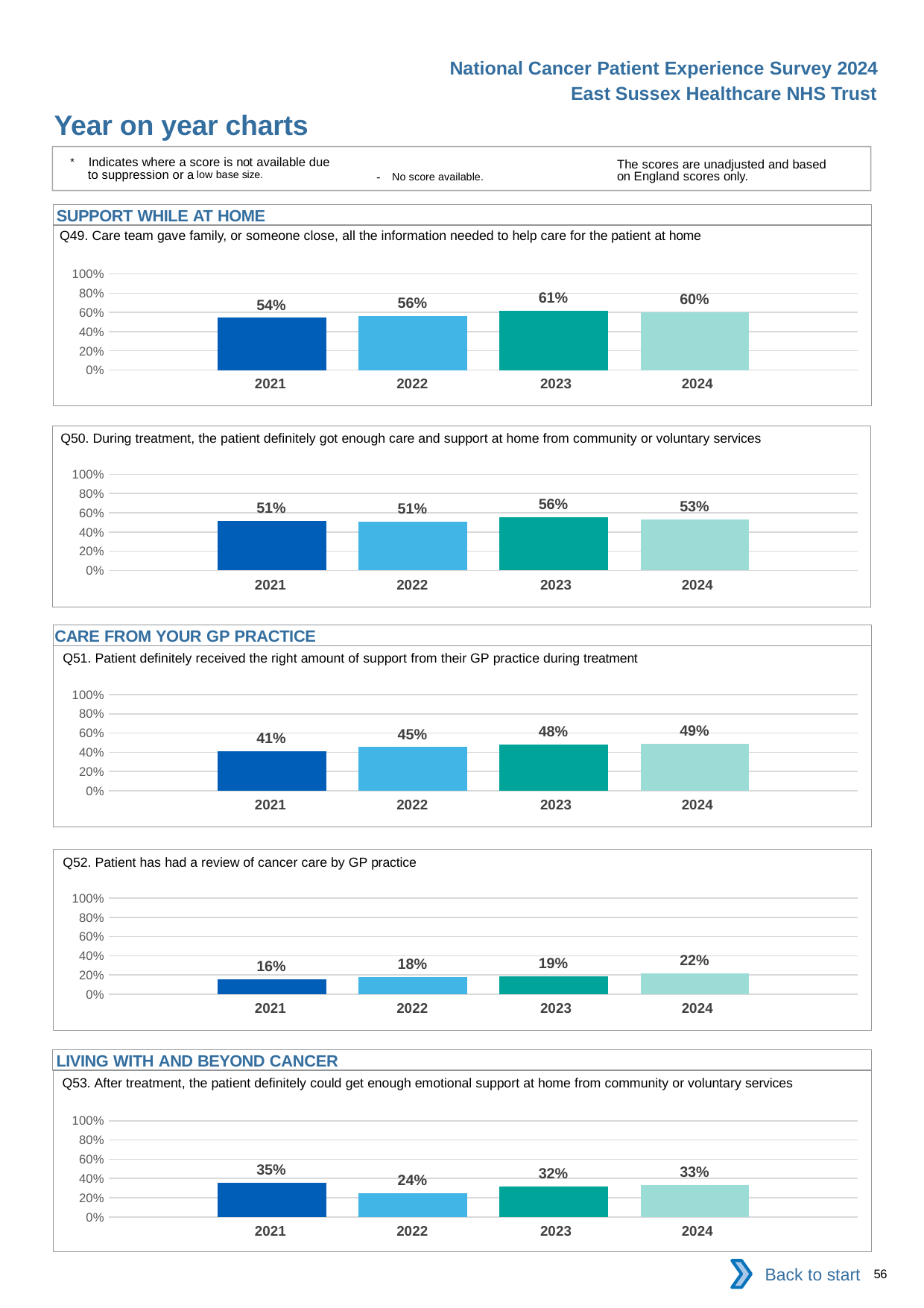
In the Q50 chart, what is the difference between the 2023 and 2024 values? 3% In the Q52 chart, is the value for 2021 greater or less than 20%? less How many years are plotted in the Q53 chart? 4 In the Q49 chart, which year has the lowest value? 2021 In the Q49 chart, what is the value for 2023? 61% In the Q52 chart, what is the value for 2024? 22% What kind of chart is the Q49 chart? bar chart In the Q53 chart, which year has the lowest value? 2022 In the Q50 chart, which year has the highest value? 2023 In the Q51 chart, do the values rise or fall from 2021 to 2024? rise In the Q53 chart, which is larger, the value for 2021 or the value for 2024? 2021 In the Q51 chart, what is the value for 2021? 41%